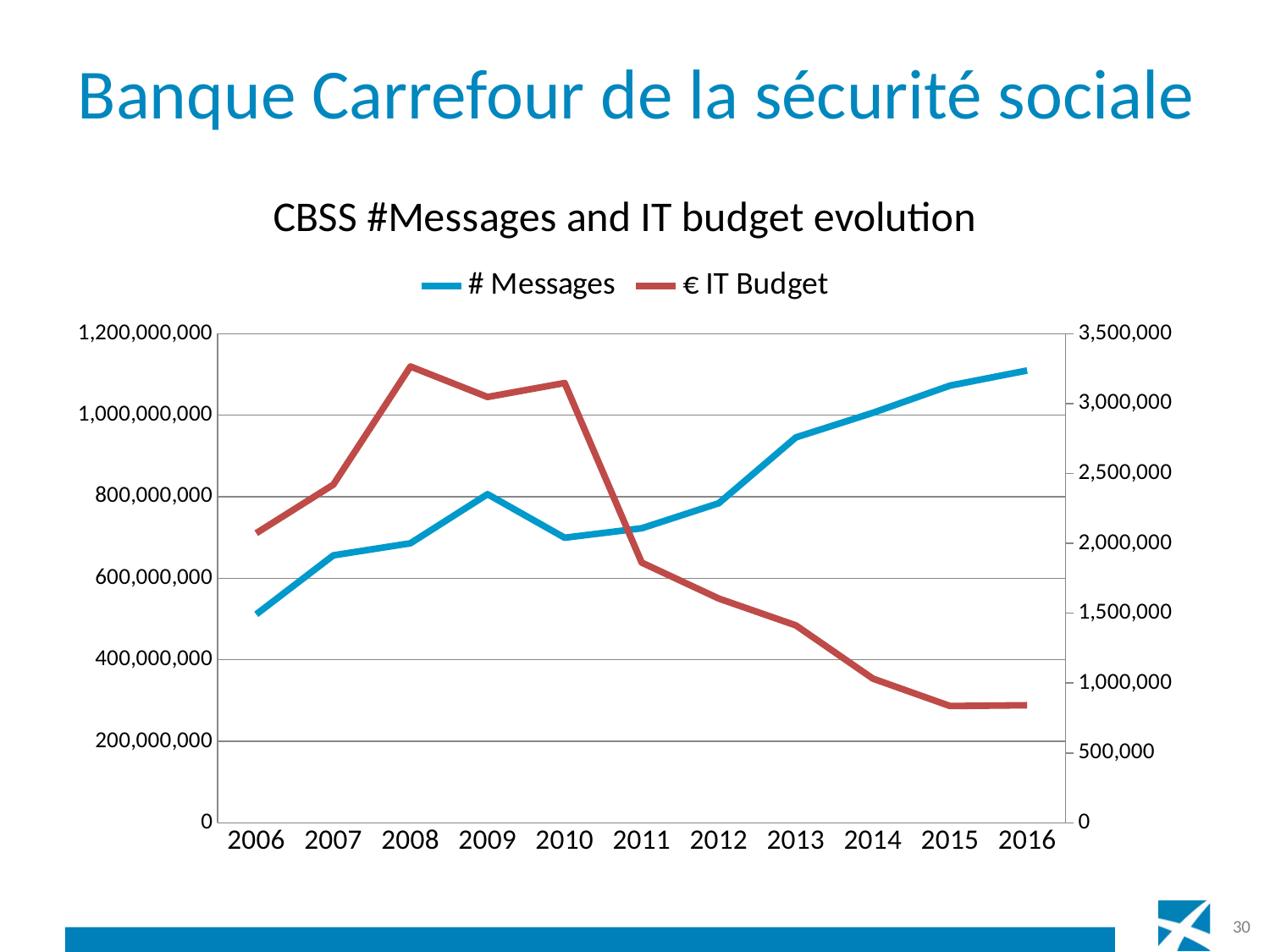
Does the € IT Budget series rise or fall from 2010 to 2016? fall Is the # Messages value for 2016 greater or less than 1,000,000,000? greater Is the € IT Budget value for 2015 greater or less than 1,000,000? less Does the # Messages series overall rise or fall from 2006 to 2016? rise In which year is the € IT Budget highest? 2008 Which series is drawn in red? € IT Budget What is the title of the chart? CBSS #Messages and IT budget evolution What kind of chart is shown on the slide? line chart In which year is the # Messages value lowest? 2006 How many years are plotted along the x axis? 11 Which year has the larger # Messages value, 2009 or 2010? 2009 How many series does the legend list? 2